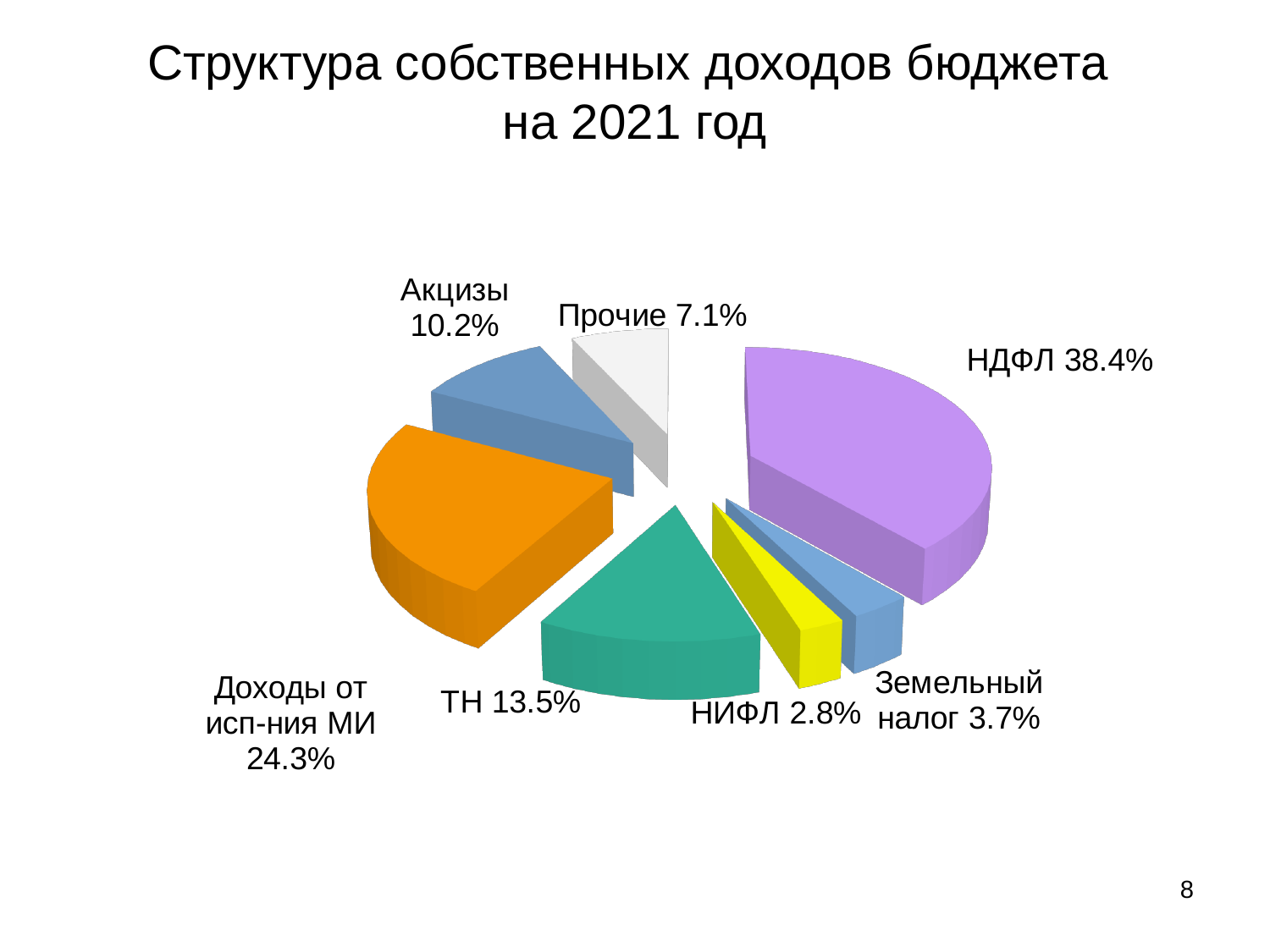
Which category has the largest slice of the pie? НДФЛ What colour is the slice for НДФЛ? Purple What is the title of the chart on the slide? Структура собственных доходов бюджета на 2021 год What is the value shown for Доходы от исп-ния МИ? 24.3% What share of the pie does НДФЛ have? 38.4% How many categories are shown in the pie chart? 7 What is the value shown for Акцизы? 10.2% Which is larger, the share of ТН or the share of Акцизы? ТН What is the difference between the shares of НДФЛ and Доходы от исп-ния МИ? 14.1% What is the value shown for Земельный налог? 3.7% Which category has the smallest slice of the pie? НИФЛ What kind of chart is shown on the slide? Pie chart